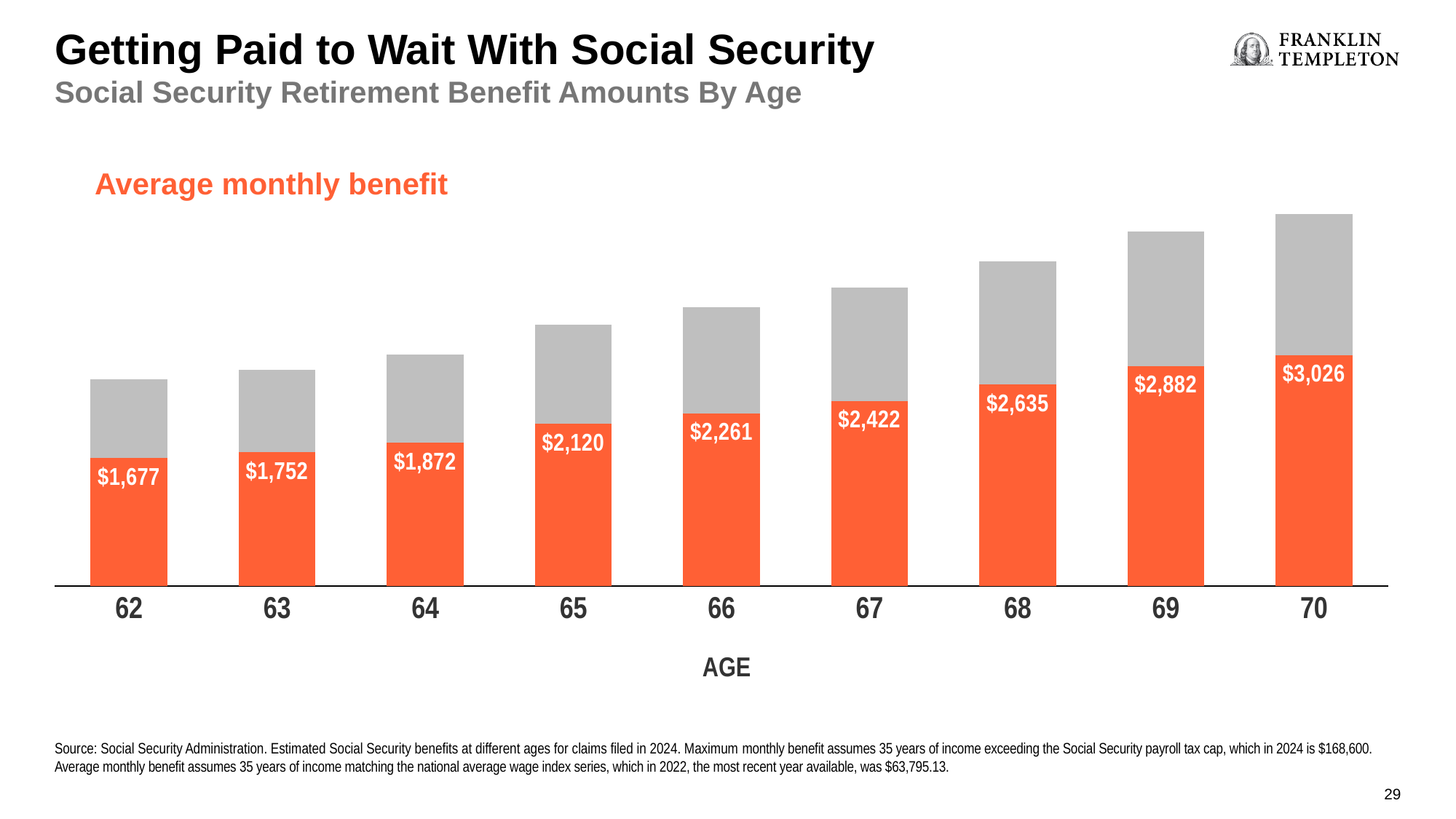
What is the average monthly benefit at age 70? $3,026 Does the average monthly benefit rise or fall as age increases from 62 to 70? Rise At which age is the average monthly benefit highest? 70 How many ages are shown on the x axis of the chart? 9 What is the difference between the average monthly benefit at age 65 and at age 64? $248 What is the average monthly benefit at age 62? $1,677 Which is larger, the average monthly benefit at age 67 or at age 69? 69 At which age is the average monthly benefit lowest? 62 What is the average monthly benefit at age 68? $2,635 What is the difference between the average monthly benefit at age 70 and at age 62? $1,349 What is the average monthly benefit at age 66? $2,261 What kind of chart is shown on the slide? Bar chart